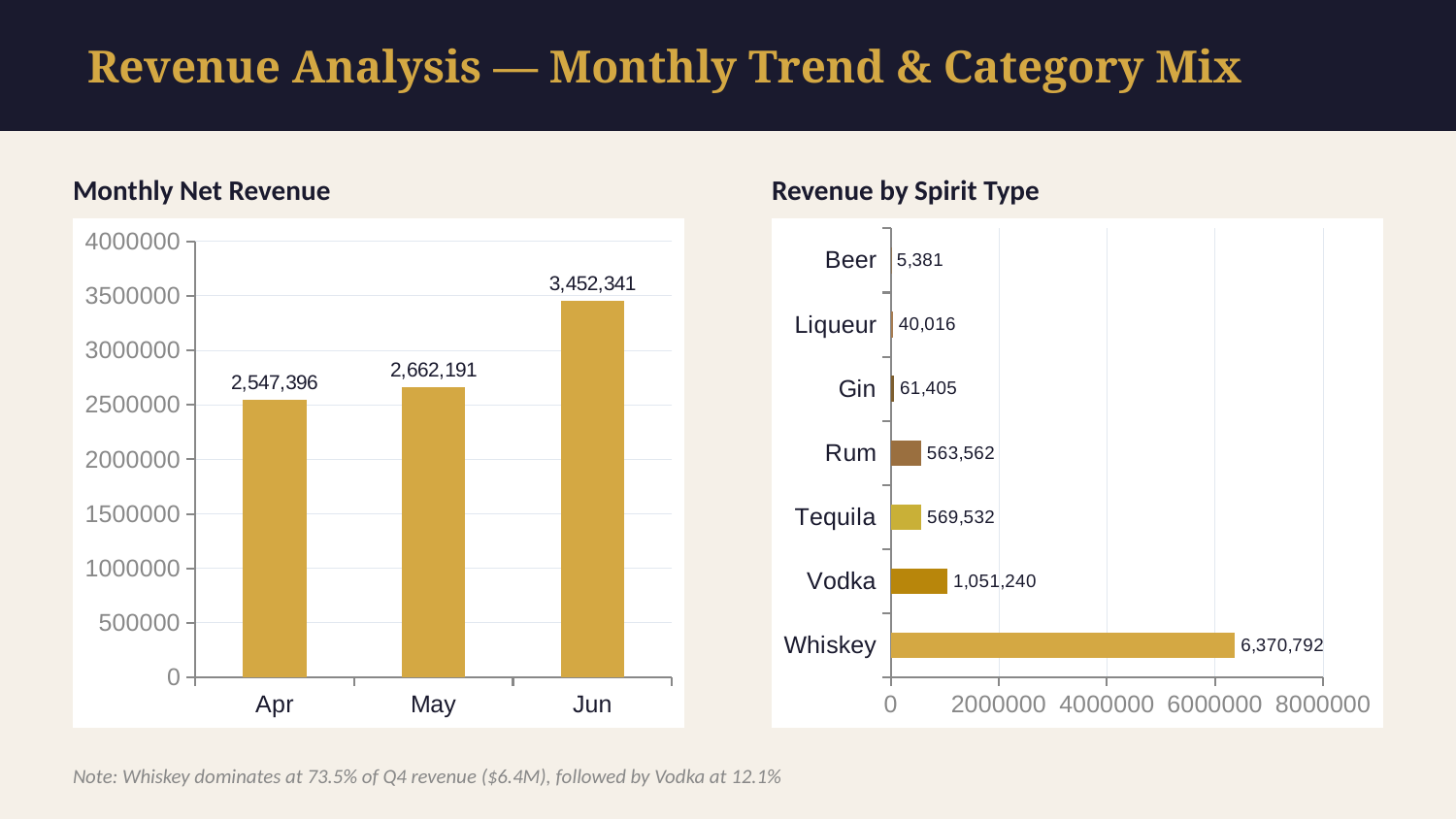
In the Monthly Net Revenue chart, what is the difference between the Jun and Apr values? 904,945 What kind of chart is the Revenue by Spirit Type chart? bar chart In the Monthly Net Revenue chart, which month has the lowest net revenue? Apr In the Revenue by Spirit Type chart, what is the difference between Whiskey and Vodka? 5,319,552 In the Monthly Net Revenue chart, what is the value for May? 2,662,191 In the Revenue by Spirit Type chart, which spirit type has the lowest revenue? Beer In the Monthly Net Revenue chart, how many months are plotted? 3 In the Revenue by Spirit Type chart, what is the value for Vodka? 1,051,240 In the Revenue by Spirit Type chart, how many spirit types are shown? 7 In the Monthly Net Revenue chart, do the values rise or fall from Apr to Jun? rise In the Monthly Net Revenue chart, which month has the highest net revenue? Jun In the Revenue by Spirit Type chart, which is larger, Rum or Vodka? Vodka